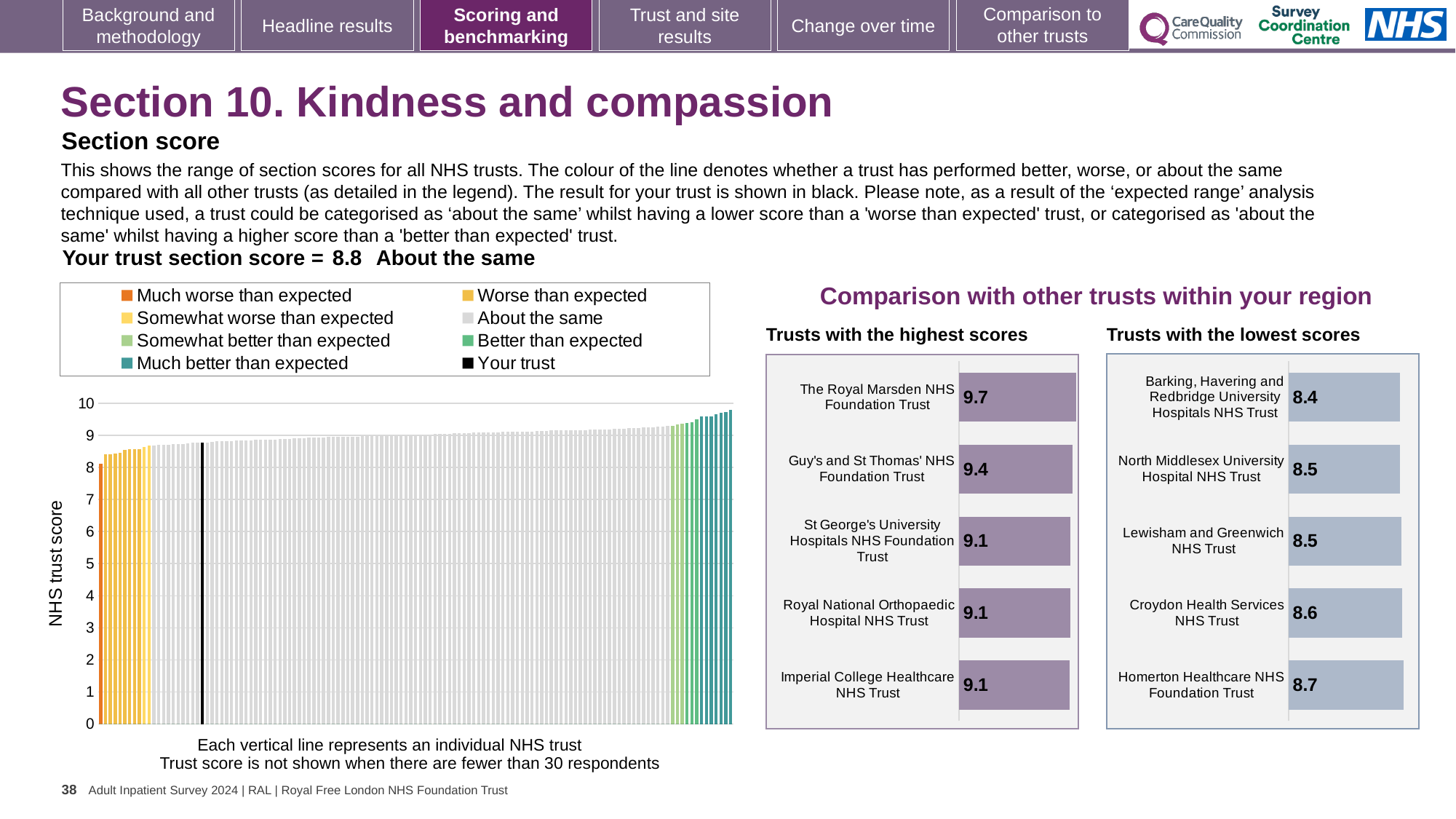
In the large chart on the left showing all NHS trusts, do the bar values rise or fall from left to right? rise How many entries does the legend of the large chart on the left list? 8 In the 'Trusts with the highest scores' chart, what is the score for The Royal Marsden NHS Foundation Trust? 9.7 In the 'Trusts with the lowest scores' chart, which trust has the lowest score? Barking, Havering and Redbridge University Hospitals NHS Trust In the 'Trusts with the highest scores' chart, how many trusts are listed? 5 In the large chart on the left showing all NHS trusts, what is the section score for your trust? 8.8 In the 'Trusts with the lowest scores' chart, which has the larger score: Homerton Healthcare NHS Foundation Trust or North Middlesex University Hospital NHS Trust? Homerton Healthcare NHS Foundation Trust In the 'Trusts with the highest scores' chart, which trust has the highest score? The Royal Marsden NHS Foundation Trust In the 'Trusts with the lowest scores' chart, what is the score for Croydon Health Services NHS Trust? 8.6 In the 'Trusts with the highest scores' chart, what is the difference between the scores of The Royal Marsden NHS Foundation Trust and Guy's and St Thomas' NHS Foundation Trust? 0.3 What kind of chart is the 'Trusts with the lowest scores' chart? bar chart In the large chart on the left showing all NHS trusts, is the value of the rightmost bar greater or less than 9? greater